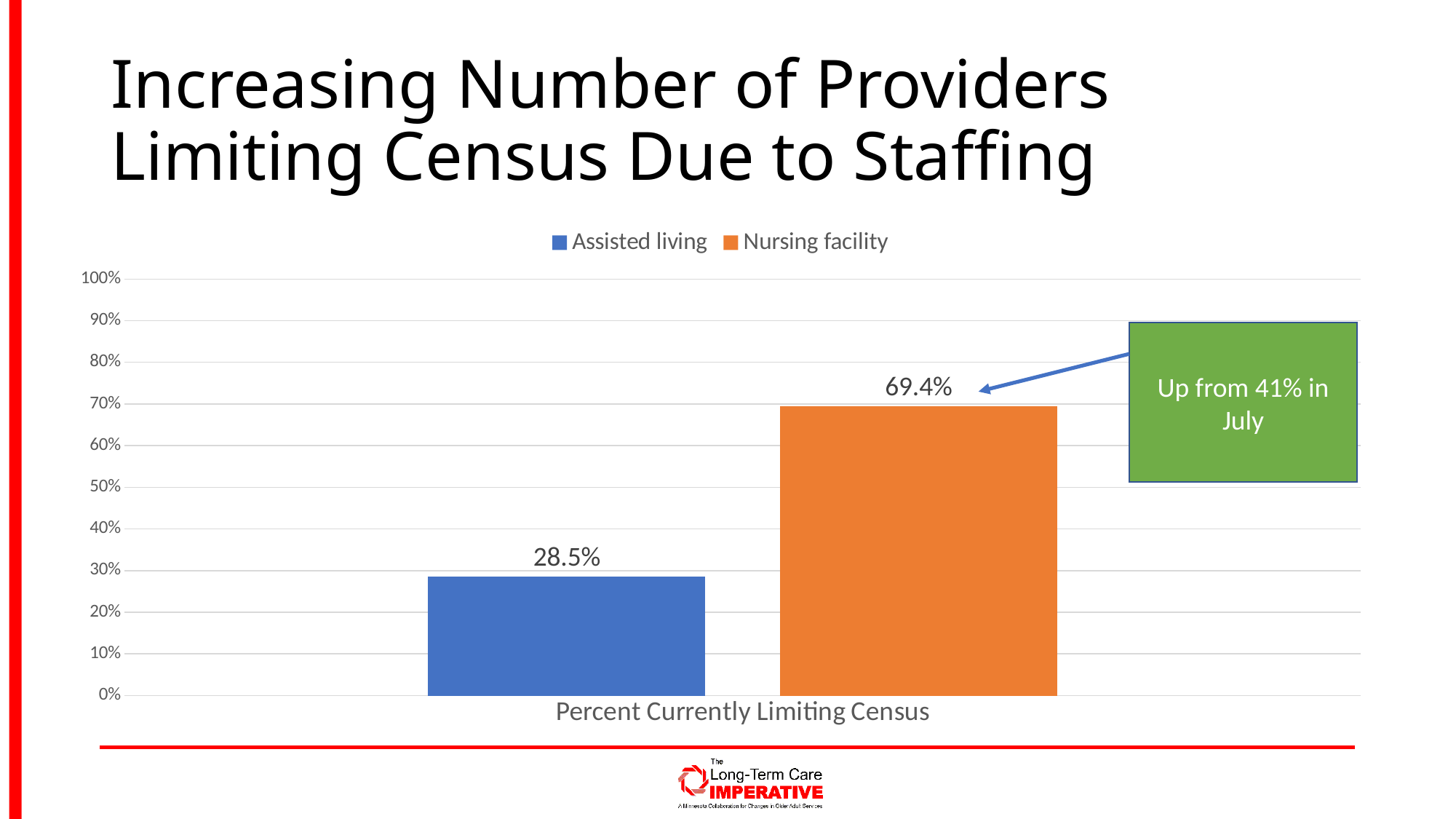
Which series has the higher value, Assisted living or Nursing facility? Nursing facility What is the highest value shown on the y axis? 100% According to the callout box, what was the Nursing facility value in July? 41% Is the value for Nursing facility greater or less than 60%? greater What is the label on the x axis of the chart? Percent Currently Limiting Census What kind of chart is shown on the slide? bar chart How many series does the legend list? 2 What is the value for Nursing facility? 69.4% What is the value for Assisted living? 28.5% Which series has the lower value? Assisted living What is the difference between the Nursing facility value and the Assisted living value? 40.9% Is the value for Assisted living greater or less than 30%? less